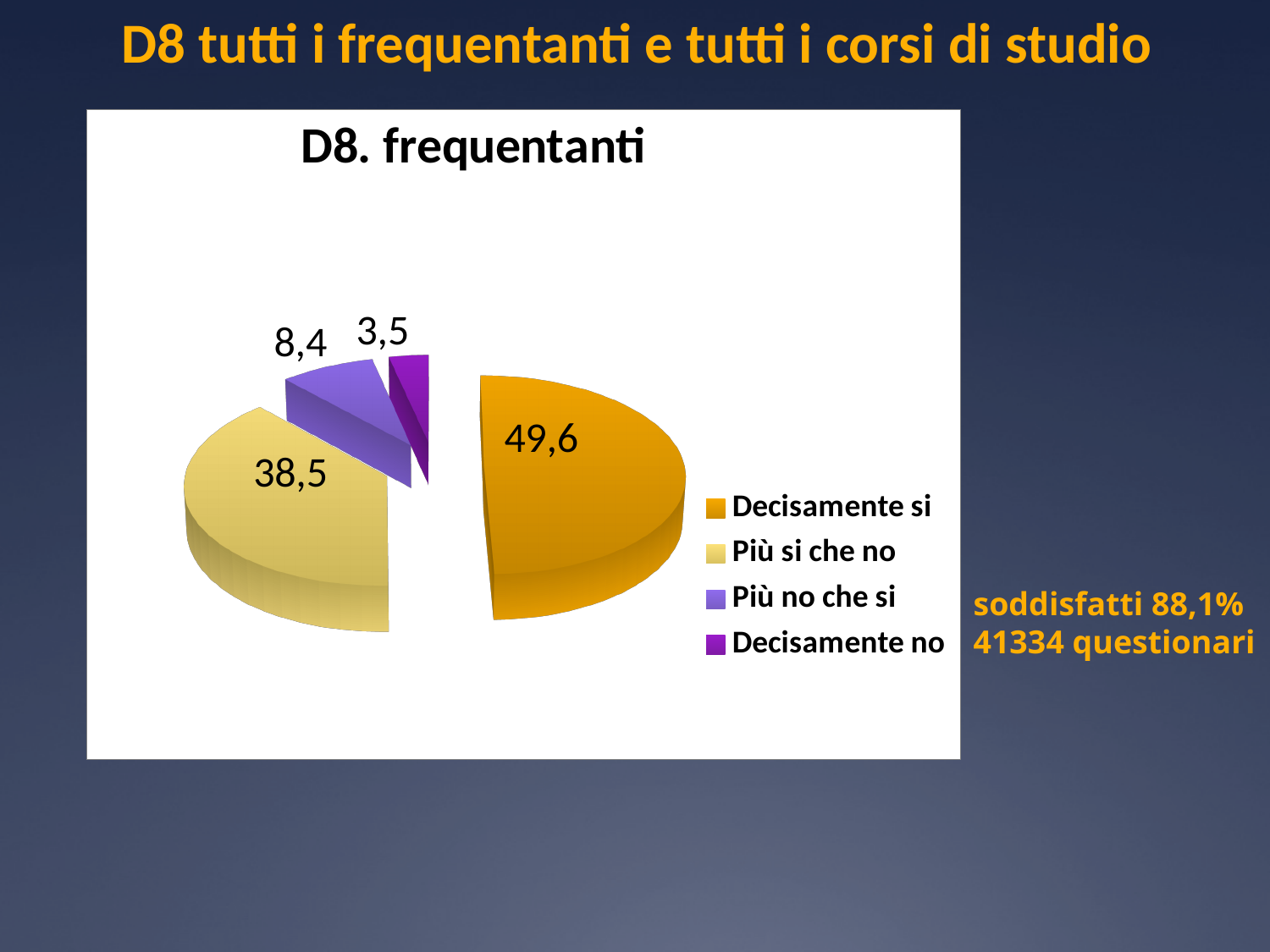
What is the value for "Più si che no"? 38,5 What is the value for "Decisamente si"? 49,6 Which colour represents "Più si che no" in the legend? Light yellow What is the difference between the values for "Decisamente si" and "Più si che no"? 11,1 How many slices does the pie chart have? 4 What kind of chart is shown on the slide? Pie chart Which category has the largest slice? Decisamente si Which category has the smallest slice? Decisamente no What is the value for "Più no che si"? 8,4 What is the value for "Decisamente no"? 3,5 Which is larger, "Più no che si" or "Decisamente no"? Più no che si What is the title of the chart? D8. frequentanti